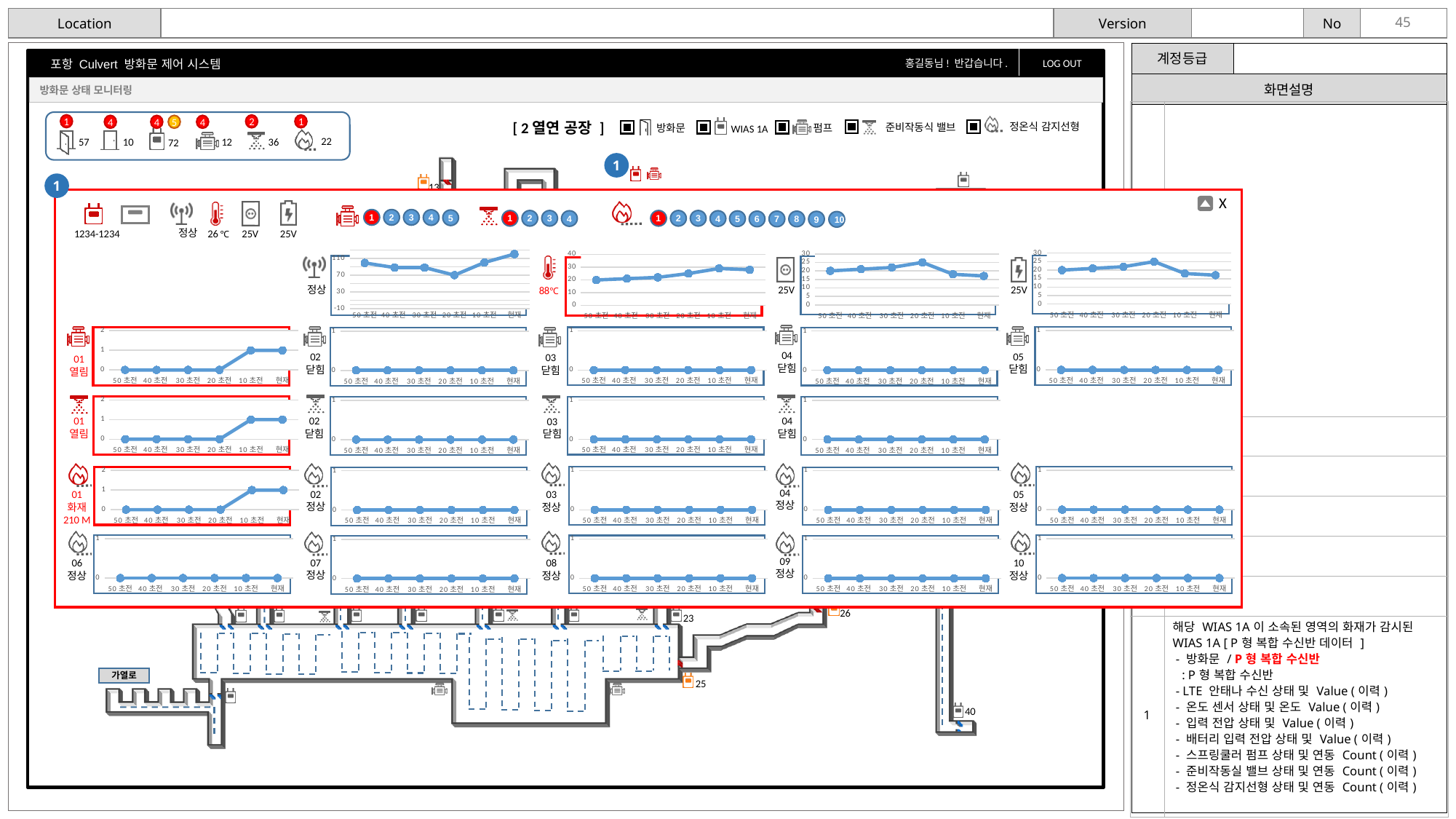
On the input voltage chart (25V, third in the top row), at which time point is the value highest? 20 초전 On the 02 닫힘 pump chart, what is the value at 현재? 0 On the 01 열림 pump chart, what is the value at 현재? 1 On the 01 화재 210 M detector chart, what is the value at 10 초전? 1 On the temperature chart (88℃) in the top row, which is larger, the value at 현재 or the value at 50 초전? 현재 On the antenna chart (정상) in the top row, at which time point is the value lowest? 20 초전 On the antenna chart (정상) in the top row, is the value at 50 초전 greater or less than 70? greater How many time points are plotted on the 01 열림 pump chart (x axis from 50 초전 to 현재)? 6 What kind of chart is used for the 01 열림 pump chart on the left of the panel? line chart On the battery chart (25V, rightmost in the top row), is the value at 20 초전 greater or less than 20? greater On the 01 열림 pump chart, do the values rise or fall from 50 초전 to 현재? rise On the 01 열림 pump chart, what is the value at 50 초전? 0